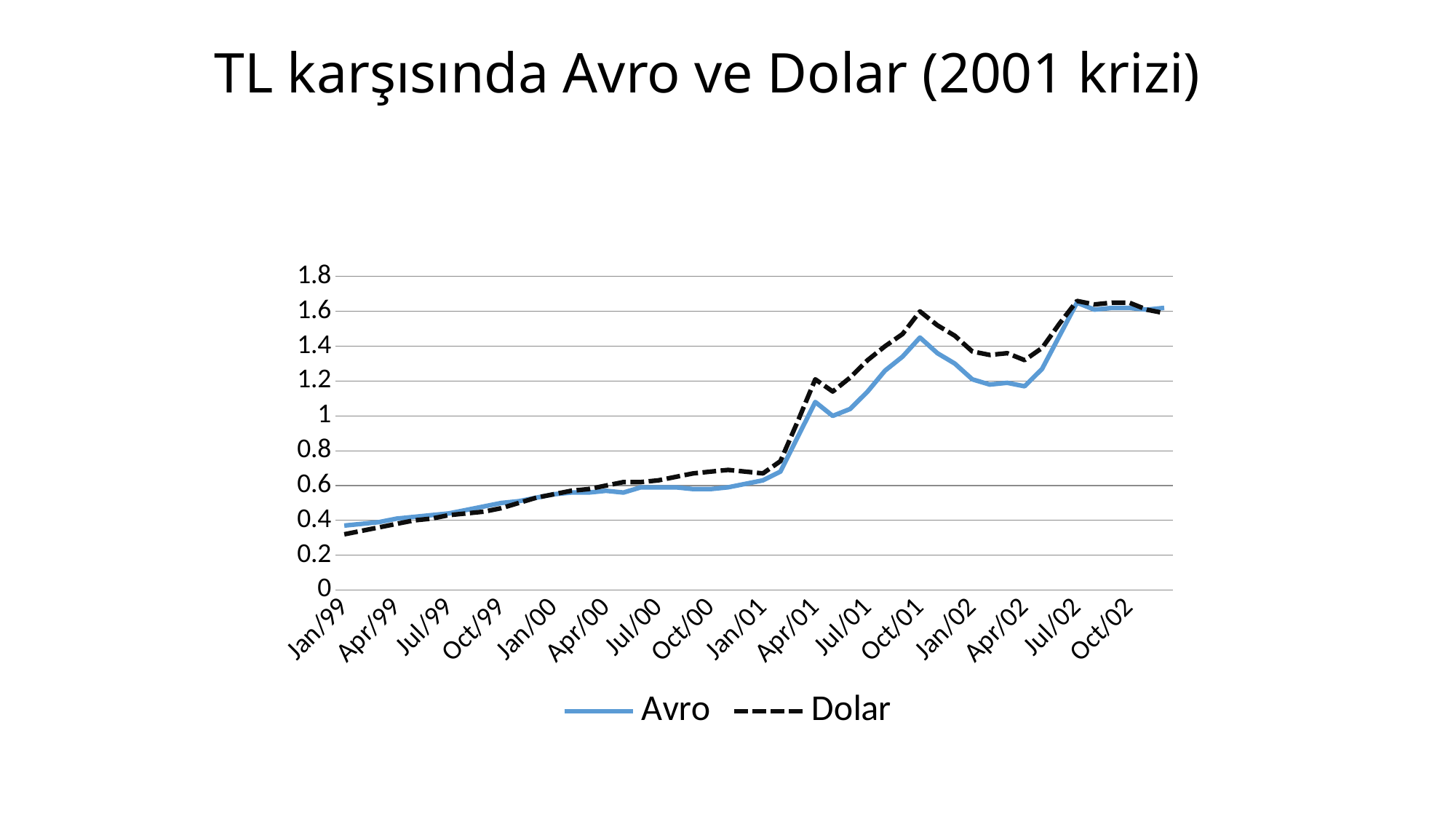
At Apr/01, which series has the higher value, Avro or Dolar? Dolar Is the value for Avro at Oct/01 greater or less than 1.2? greater Is the value for Avro at Apr/01 greater or less than 1? greater Overall, do the values for Avro rise or fall from Jan/99 to Oct/02? rise What is the title of the chart? TL karşısında Avro ve Dolar (2001 krizi) At Jan/99, which series has the higher value, Avro or Dolar? Avro Is the value for Dolar at Jan/02 greater or less than 1.2? greater Which series is drawn with a dashed line? Dolar What kind of chart is shown on the slide? line chart How many series does the legend list? 2